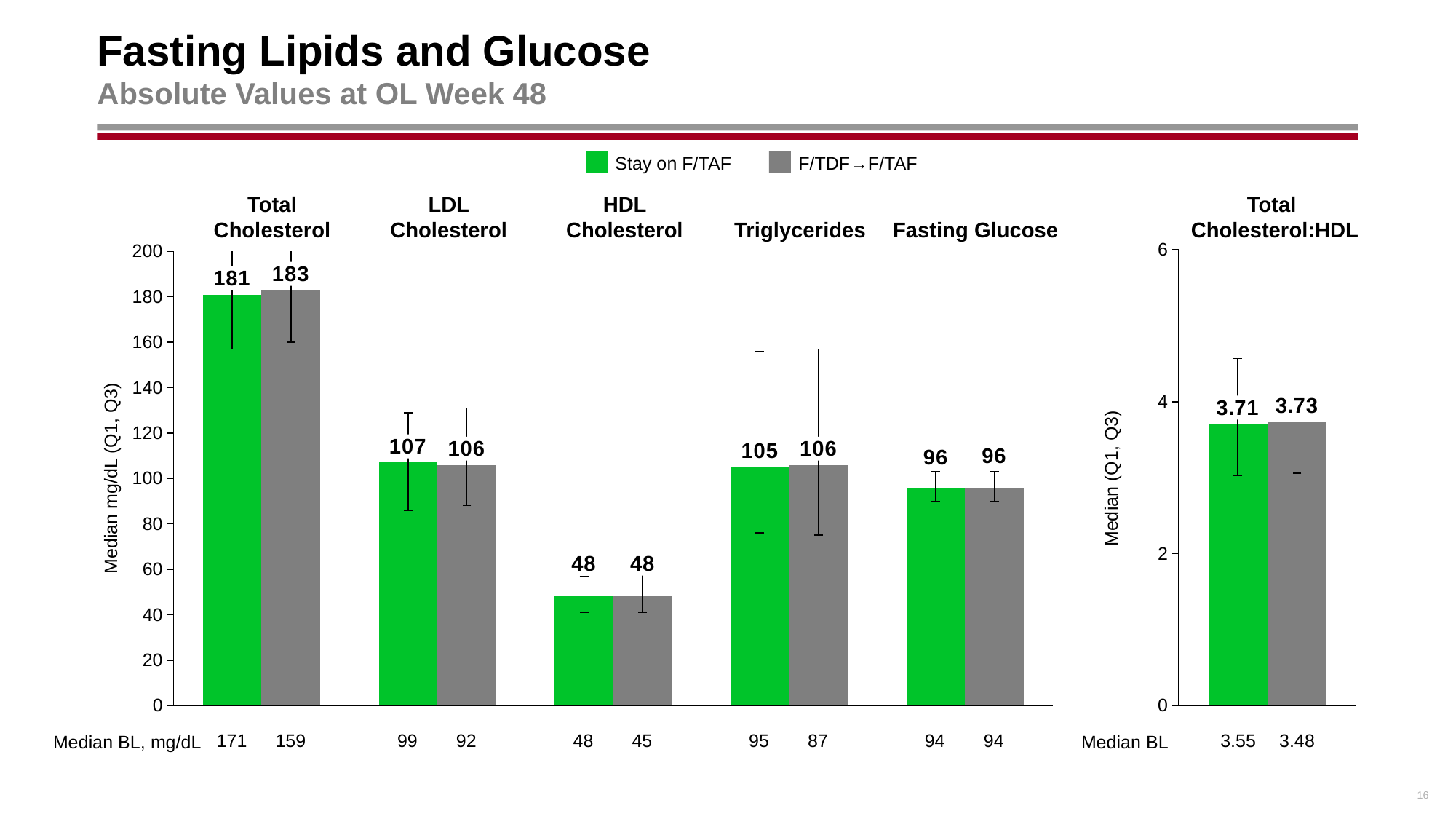
What kind of chart is the left chart? Bar chart How many series does the legend list? 2 In the left chart, what is the value for Stay on F/TAF for Total Cholesterol? 181 In the left chart, which is larger: the Stay on F/TAF value for Triglycerides or for Fasting Glucose? Triglycerides How many categories are shown in the left chart? 5 In the left chart, what is the value for F/TDF→F/TAF for LDL Cholesterol? 106 In the right chart (Total Cholesterol:HDL), what is the value for F/TDF→F/TAF? 3.73 In the left chart, what is the value for Stay on F/TAF for Triglycerides? 105 What is the y-axis label of the right chart? Median (Q1, Q3) In the left chart, which category has the highest values? Total Cholesterol In the left chart, which category has the lowest values? HDL Cholesterol In the left chart, what is the difference between the Stay on F/TAF values for Total Cholesterol and LDL Cholesterol? 74